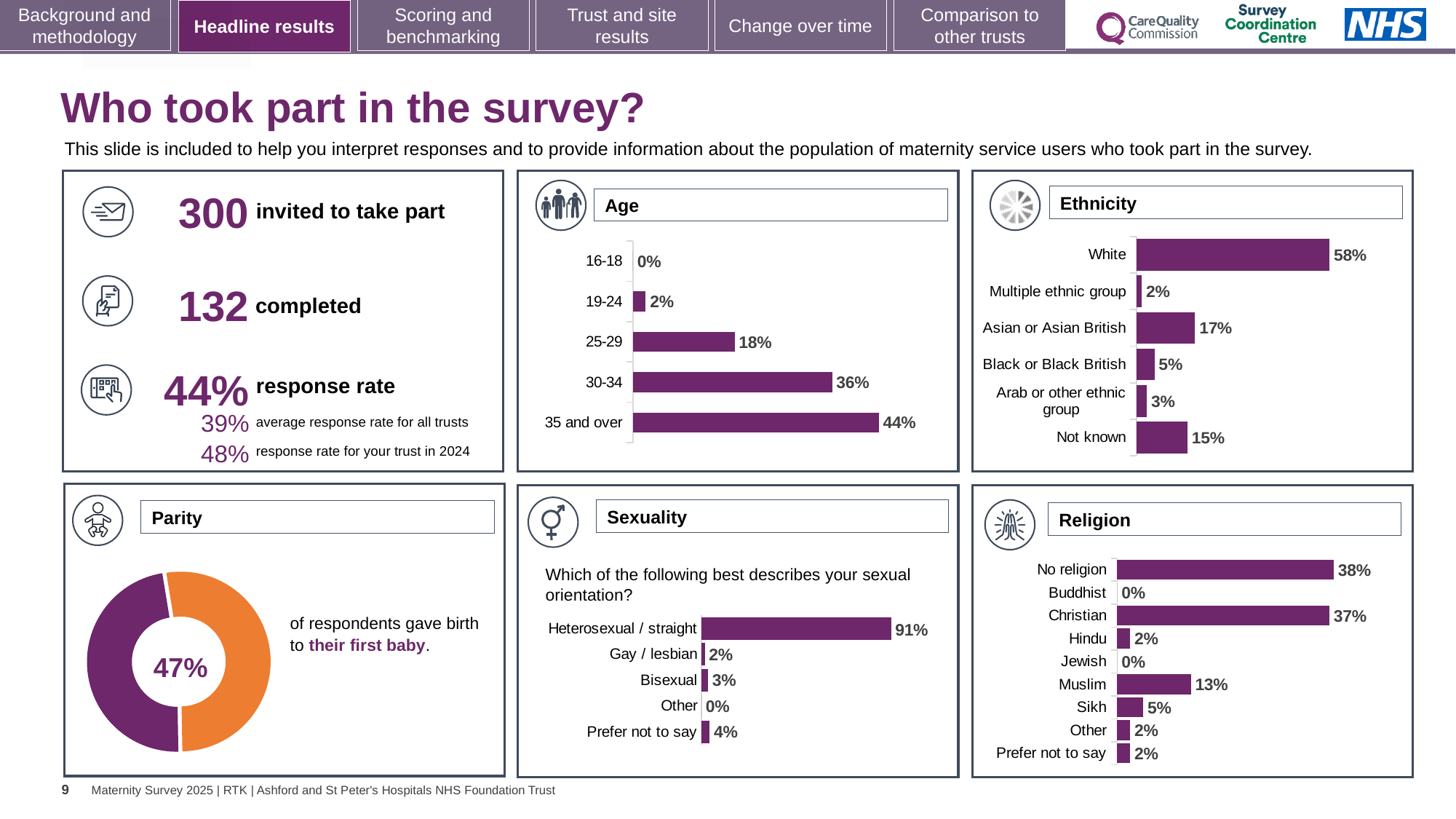
In the Ethnicity chart, how many ethnicity categories are shown? 6 In the Ethnicity chart, which category has the highest percentage? White In the Age chart, what percentage of respondents were aged 30-34? 36% In the Religion chart, what is the difference between No religion and Christian? 1 percentage point What kind of chart is the Parity chart? Doughnut chart In the Religion chart, what percentage of respondents were Muslim? 13% In the Ethnicity chart, what percentage of respondents were Asian or Asian British? 17% In the Sexuality chart, what percentage of respondents answered Heterosexual / straight? 91% In the Age chart, which age group has the highest percentage? 35 and over In the Parity chart, what percentage of respondents gave birth to their first baby? 47% In the Sexuality chart, which is larger, Bisexual or Gay / lesbian? Bisexual In the Age chart, what is the difference between the 35 and over group and the 25-29 group? 26 percentage points